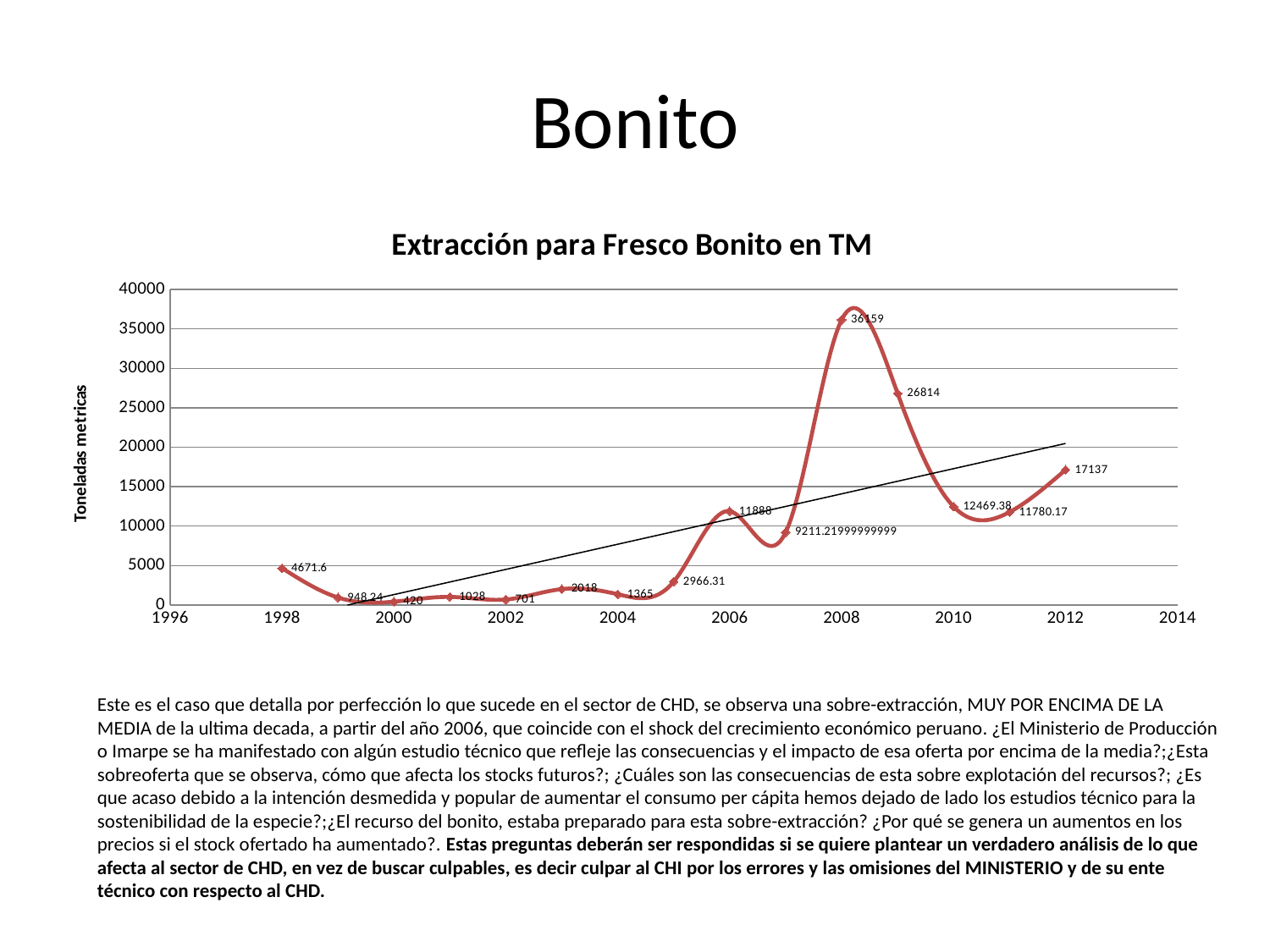
What is the title of the chart? Extracción para Fresco Bonito en TM What is the value for 2012? 17137 What is the value for 2008? 36159 What is the label of the vertical axis? Toneladas metricas What is the difference between the values for 2008 and 2009? 9345 What is the value for 1998? 4671.6 Which year has the lowest value? 2000 Is the value for 2009 greater or less than 25000? greater What is the value for 2010? 12469.38 Which year has the highest value? 2008 Which is larger, the value for 2006 or the value for 2007? 2006 What type of chart is shown on the slide? line chart